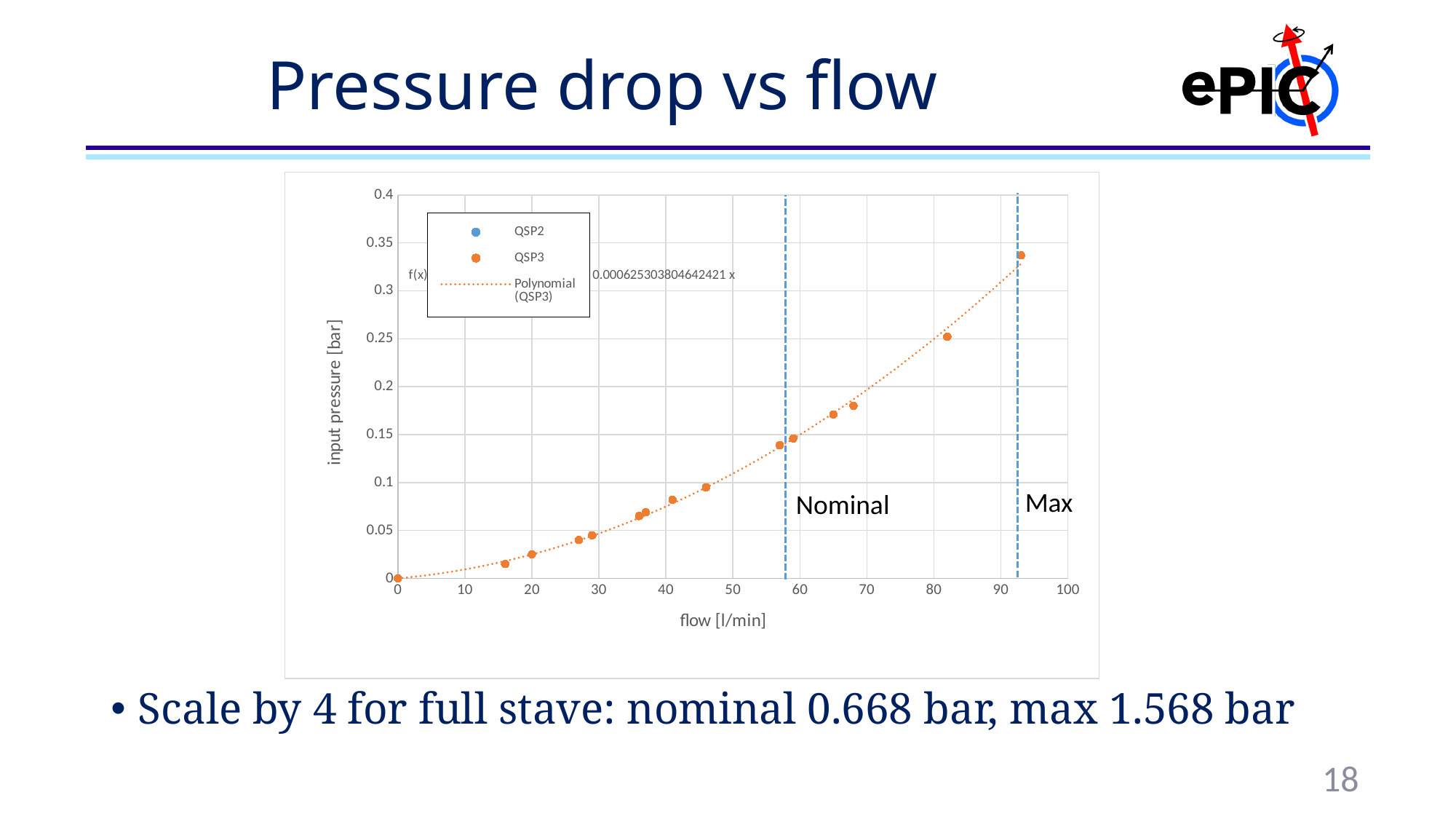
What is the label of the x axis of the chart? flow [l/min] How many entries does the chart legend list? 3 Does the input pressure rise or fall as flow increases along the x axis? rises Is the input pressure at the Max flow line greater or less than 0.3 bar? greater Is the input pressure at a flow of 20 l/min greater or less than 0.05 bar? less What kind of chart is shown on the slide? scatter chart Is the input pressure at a flow of about 46 l/min greater or less than 0.15 bar? less What do the two vertical dashed lines on the chart mark? Nominal and Max